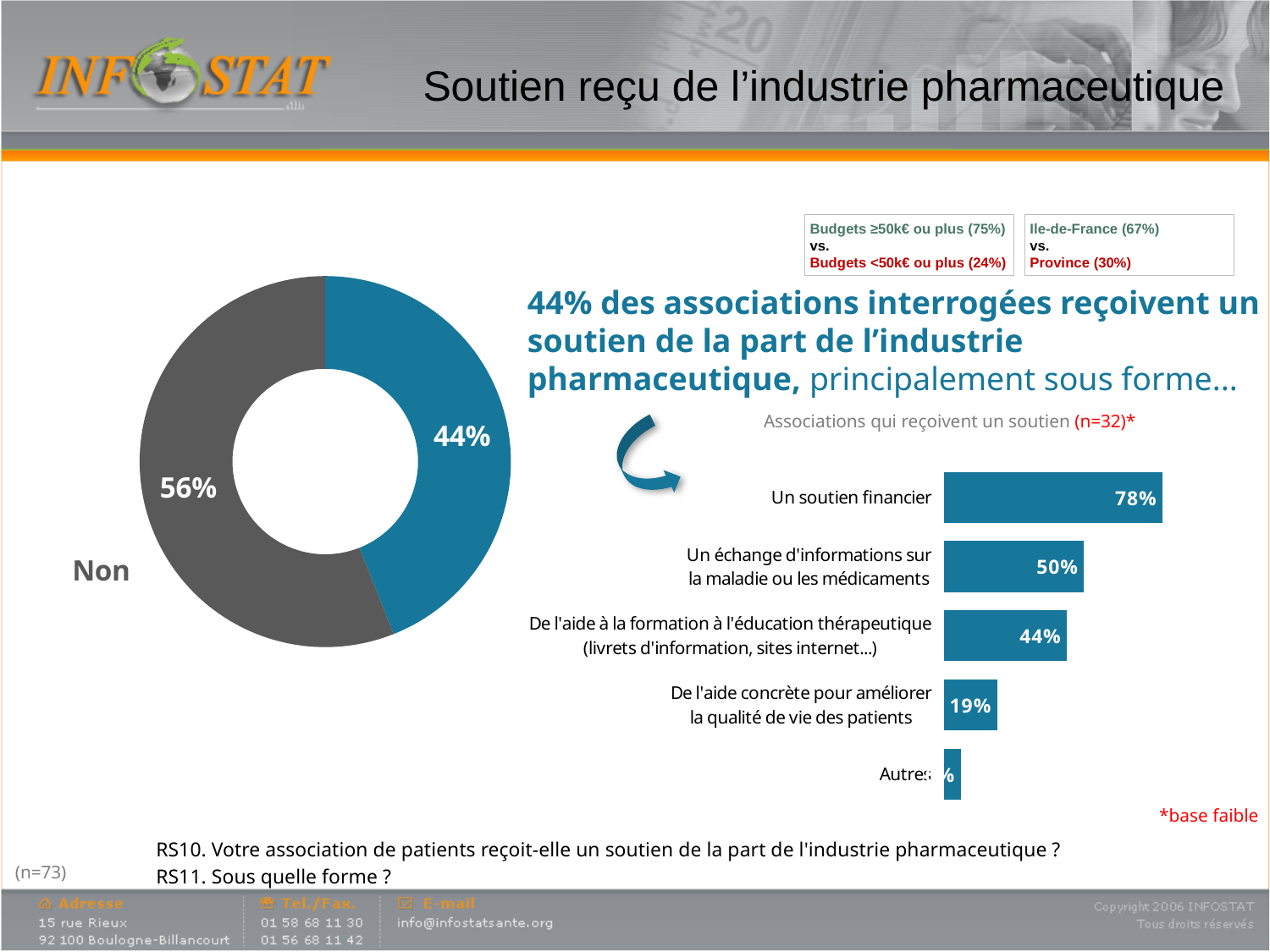
What kind of chart is the chart on the left of the slide? Donut (pie) chart In the bar chart on the right, what is the value for "Un échange d'informations sur la maladie ou les médicaments"? 50% In the donut chart on the left, which slice is larger, the grey "Non" slice or the blue slice? The grey "Non" slice In the donut chart on the left, what share is labelled "Non"? 56% In the donut chart on the left, what is the difference between the "Non" share and the blue slice's share? 12 percentage points In the bar chart on the right, what is the value for "De l'aide à la formation à l'éducation thérapeutique (livrets d'information, sites internet...)"? 44% In the donut chart on the left, what is the value of the blue slice? 44% In the bar chart on the right, what is the value for "Un soutien financier"? 78% In the bar chart on the right, which category has the highest value? Un soutien financier In the bar chart on the right, what is the value for "De l'aide concrète pour améliorer la qualité de vie des patients"? 19% In the bar chart on the right, what is the difference between "Un soutien financier" and "Un échange d'informations sur la maladie ou les médicaments"? 28 percentage points What kind of chart is the chart on the right of the slide? Bar chart